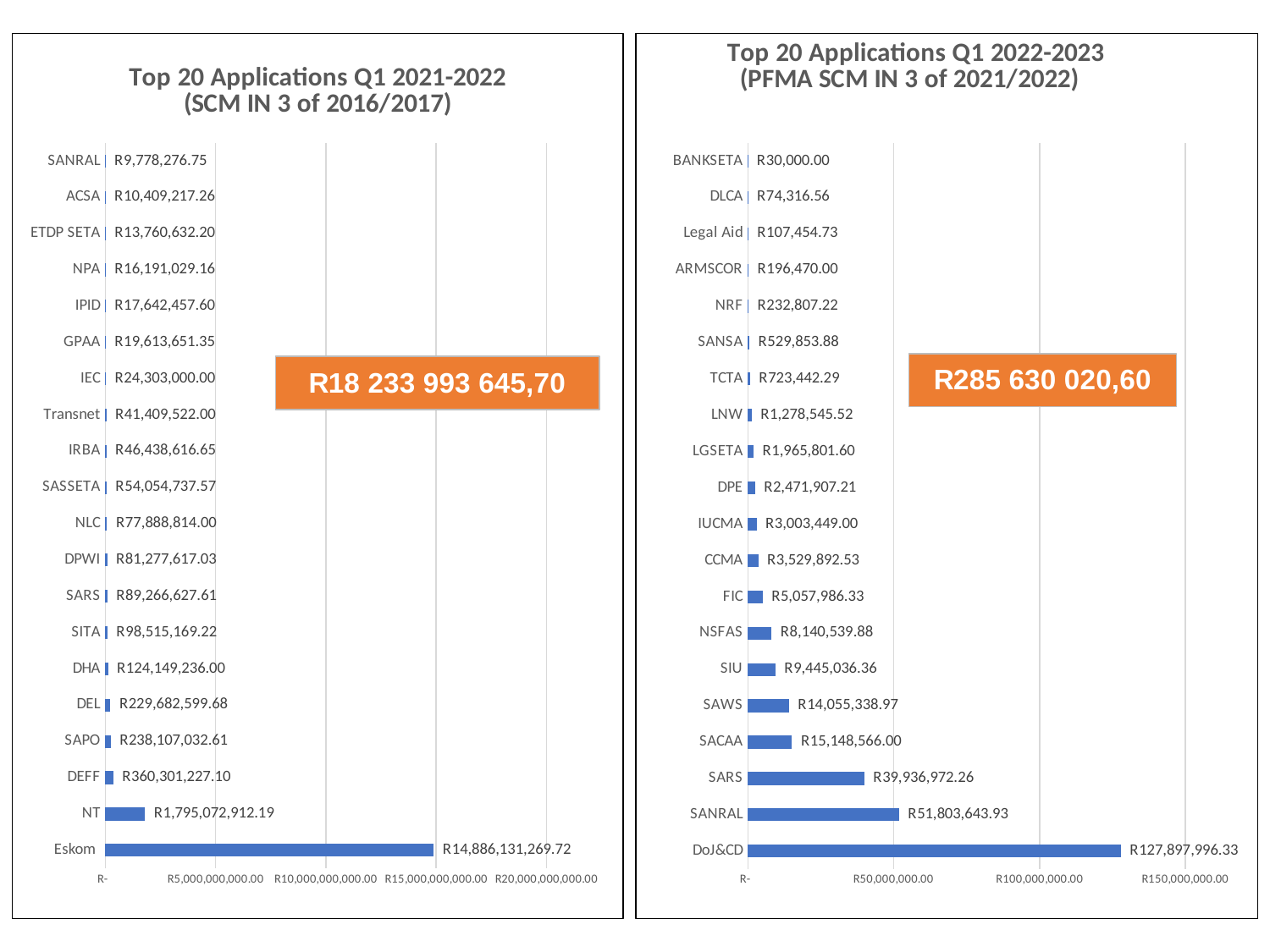
In the 'Top 20 Applications Q1 2022-2023' chart, which category has the lowest value? BANKSETA In the 'Top 20 Applications Q1 2022-2023' chart, which is larger, the value for SANRAL or the value for SARS? SANRAL In the 'Top 20 Applications Q1 2021-2022' chart, what is the value for NT? R1,795,072,912.19 In the 'Top 20 Applications Q1 2021-2022' chart, is the value for Eskom greater or less than R10,000,000,000.00? greater In the 'Top 20 Applications Q1 2022-2023' chart, what is the value for SARS? R39,936,972.26 How many categories are shown in the 'Top 20 Applications Q1 2022-2023' chart? 20 In the 'Top 20 Applications Q1 2021-2022' chart, which category has the highest value? Eskom In the 'Top 20 Applications Q1 2021-2022' chart, which category has the lowest value? SANRAL In the 'Top 20 Applications Q1 2022-2023' chart, what is the value for DoJ&CD? R127,897,996.33 In the 'Top 20 Applications Q1 2021-2022' chart, what is the value for Eskom? R14,886,131,269.72 What type of chart is the 'Top 20 Applications Q1 2021-2022' chart? bar chart In the 'Top 20 Applications Q1 2022-2023' chart, is the value for DoJ&CD greater or less than R100,000,000.00? greater